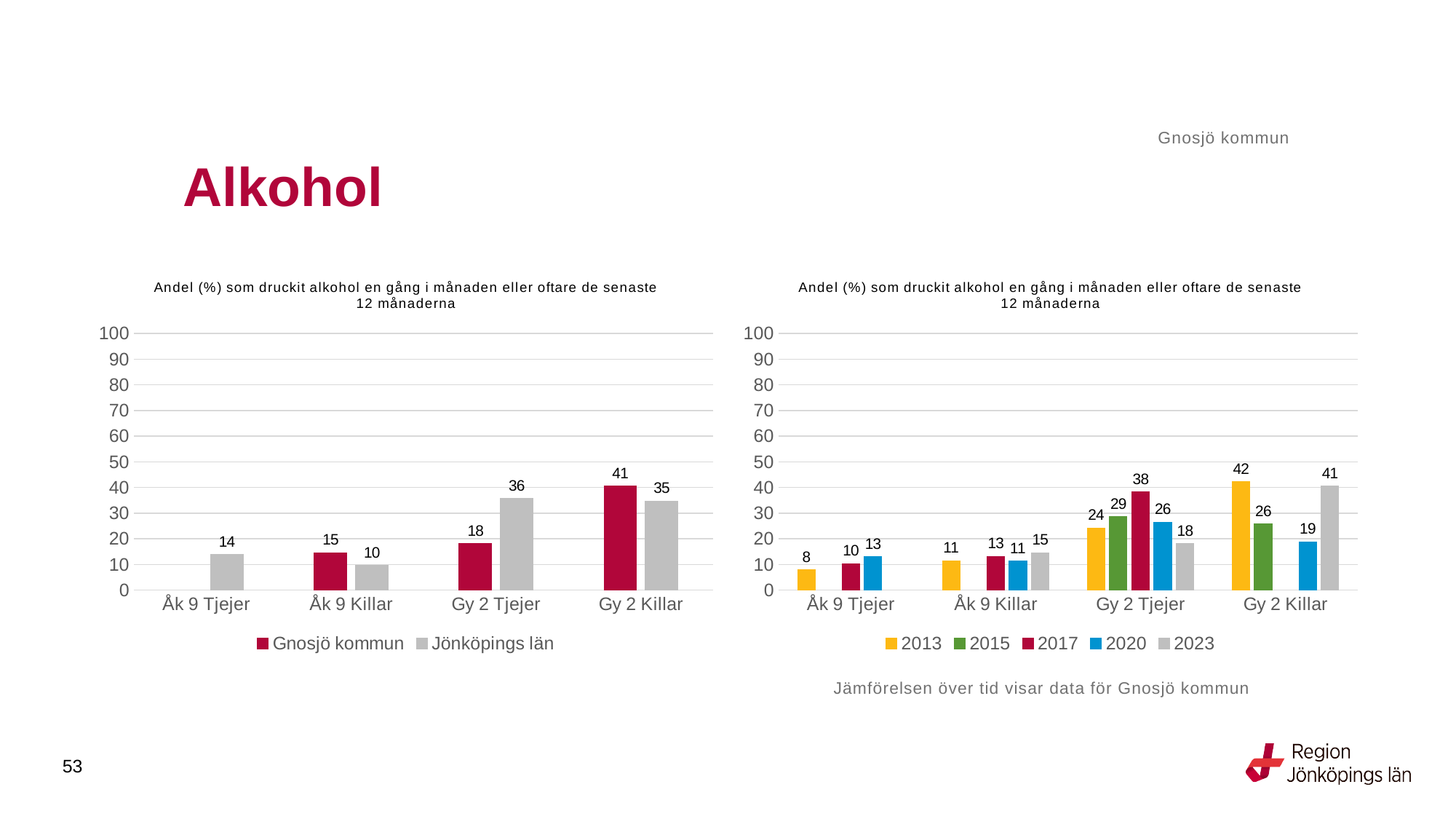
In the right chart, what is the value for 2013 for Gy 2 Killar? 42 How many series does the legend of the right chart list? 5 In the left chart, which category has the lowest value for Jönköpings län? Åk 9 Killar In the right chart, what is the value for 2017 for Gy 2 Tjejer? 38 How many series does the legend of the left chart list? 2 In the right chart, which is larger for Gy 2 Killar: 2015 or 2023? 2023 In the left chart, what is the value for Gnosjö kommun for Gy 2 Killar? 41 In the right chart, which year has the highest value for Gy 2 Tjejer? 2017 In the left chart, what is the value for Jönköpings län for Gy 2 Tjejer? 36 In the left chart, is the value for Gnosjö kommun for Gy 2 Killar greater or less than 40? greater What type of chart is the right chart? Bar chart In the left chart, what is the difference between Jönköpings län and Gnosjö kommun for Gy 2 Tjejer? 18